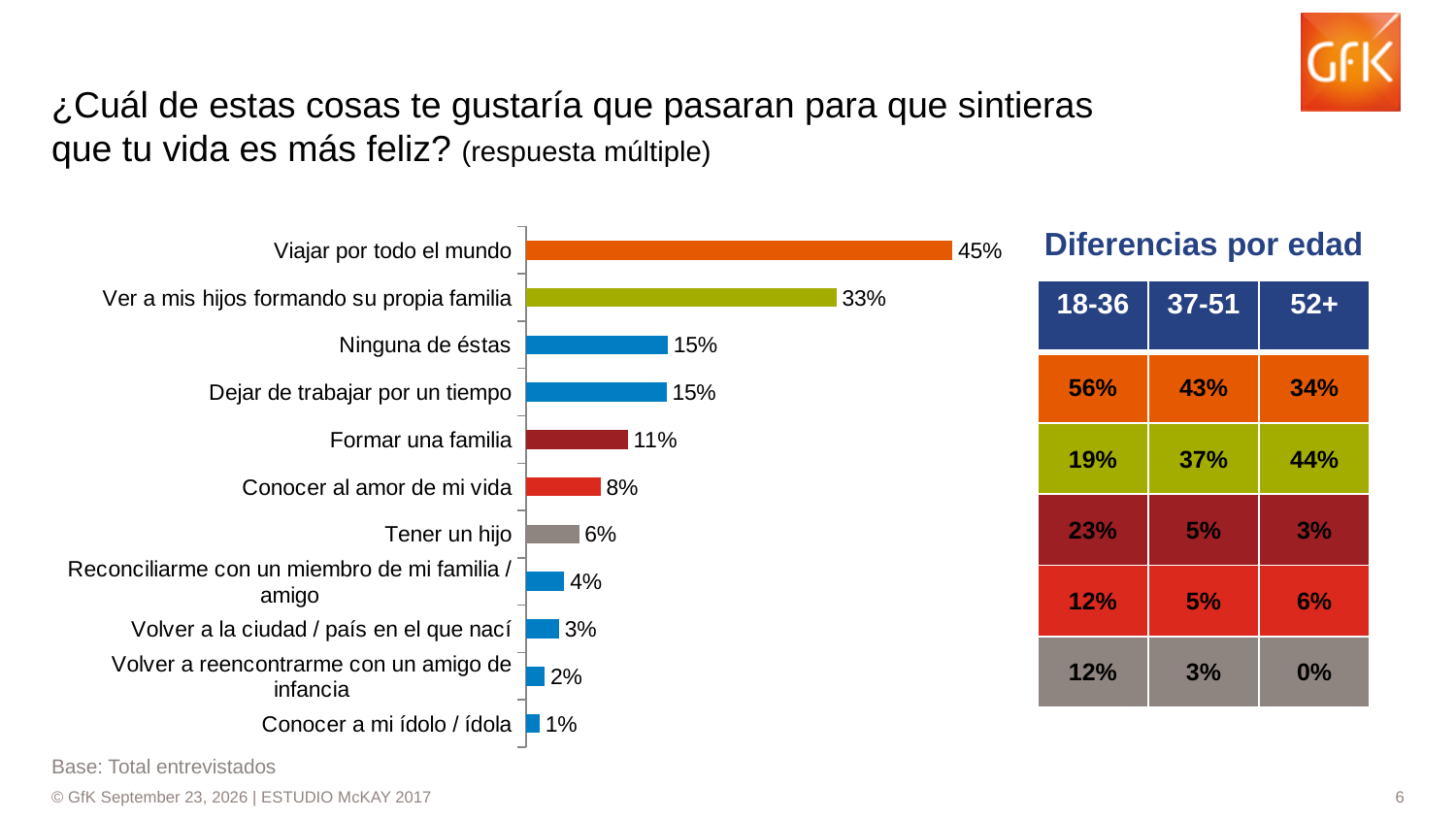
Which category has the lowest value? Conocer a mi ídolo / ídola Which category has the highest value? Viajar por todo el mundo What is the value for "Viajar por todo el mundo"? 45% What is the difference between "Ninguna de éstas" and "Tener un hijo"? 9% What is the value for "Conocer al amor de mi vida"? 8% What is the value for "Ver a mis hijos formando su propia familia"? 33% How many categories are shown in the bar chart? 11 What is the title of the table to the right of the chart? Diferencias por edad What is the difference between "Viajar por todo el mundo" and "Ver a mis hijos formando su propia familia"? 12% Which is larger, "Tener un hijo" or "Conocer al amor de mi vida"? Conocer al amor de mi vida What is the value for "Formar una familia"? 11% What kind of chart is shown on the slide? Bar chart